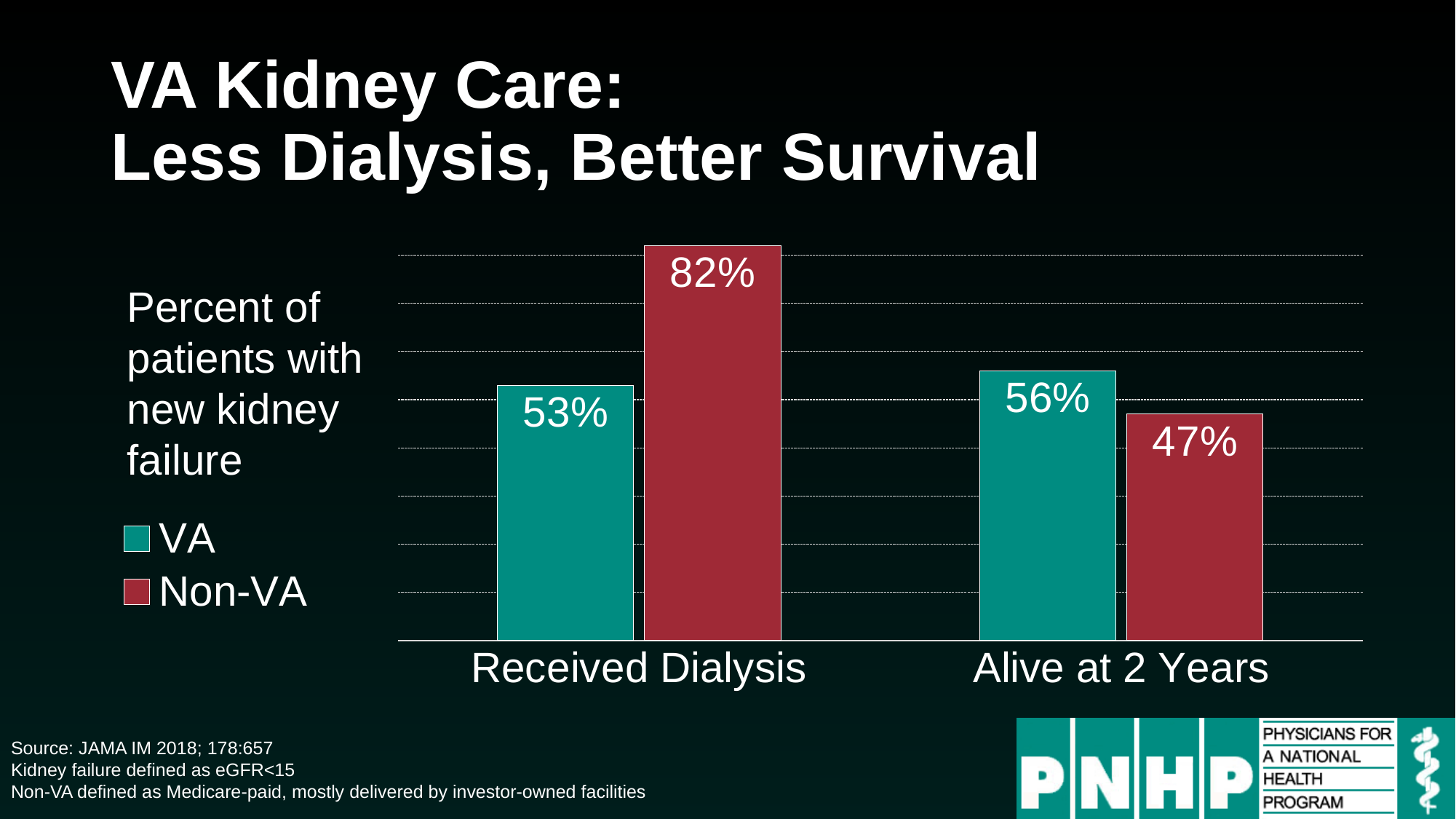
For Alive at 2 Years, which group has the larger value, VA or Non-VA? VA What is the difference between the Non-VA and VA percentages for Received Dialysis? 29% How many categories are shown on the x axis? 2 What percent of VA patients received dialysis? 53% What is the difference between the VA and Non-VA percentages for Alive at 2 Years? 9% What percent of Non-VA patients received dialysis? 82% What percent of VA patients were alive at 2 years? 56% What kind of chart is shown on the slide? Bar chart What percent of Non-VA patients were alive at 2 years? 47% Which bar shows the highest value on the chart? Non-VA, Received Dialysis How many series does the legend list? 2 Which bar shows the lowest value on the chart? Non-VA, Alive at 2 Years